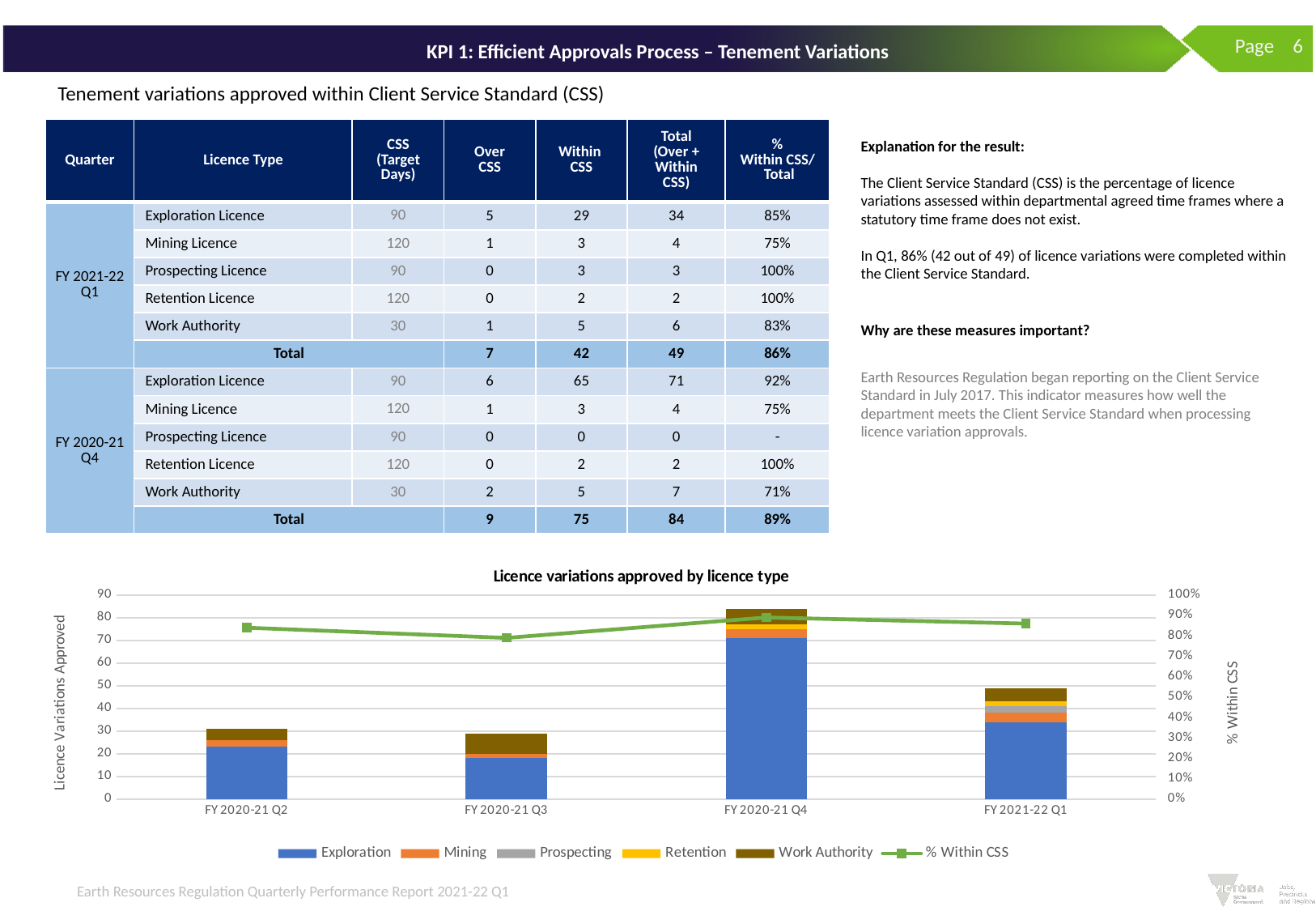
What is the title of the chart on the slide? Licence variations approved by licence type Which quarter has the lowest point on the % Within CSS line? FY 2020-21 Q3 What kind of chart is shown on the slide? Stacked bar chart with a line Is the stacked bar for FY 2020-21 Q4 taller than the stacked bar for FY 2021-22 Q1? Yes, FY 2020-21 Q4 What is the label of the right-hand vertical axis of the chart? % Within CSS Is the % Within CSS value for FY 2020-21 Q3 greater or less than 70%? greater Is the total height of the stacked bar for FY 2020-21 Q2 greater or less than 40? less How many series does the chart legend list? 6 Is the total height of the stacked bar for FY 2020-21 Q4 greater or less than 80? greater How many quarters are shown on the x axis of the chart? 4 Which quarter has the tallest stacked bar in the chart? FY 2020-21 Q4